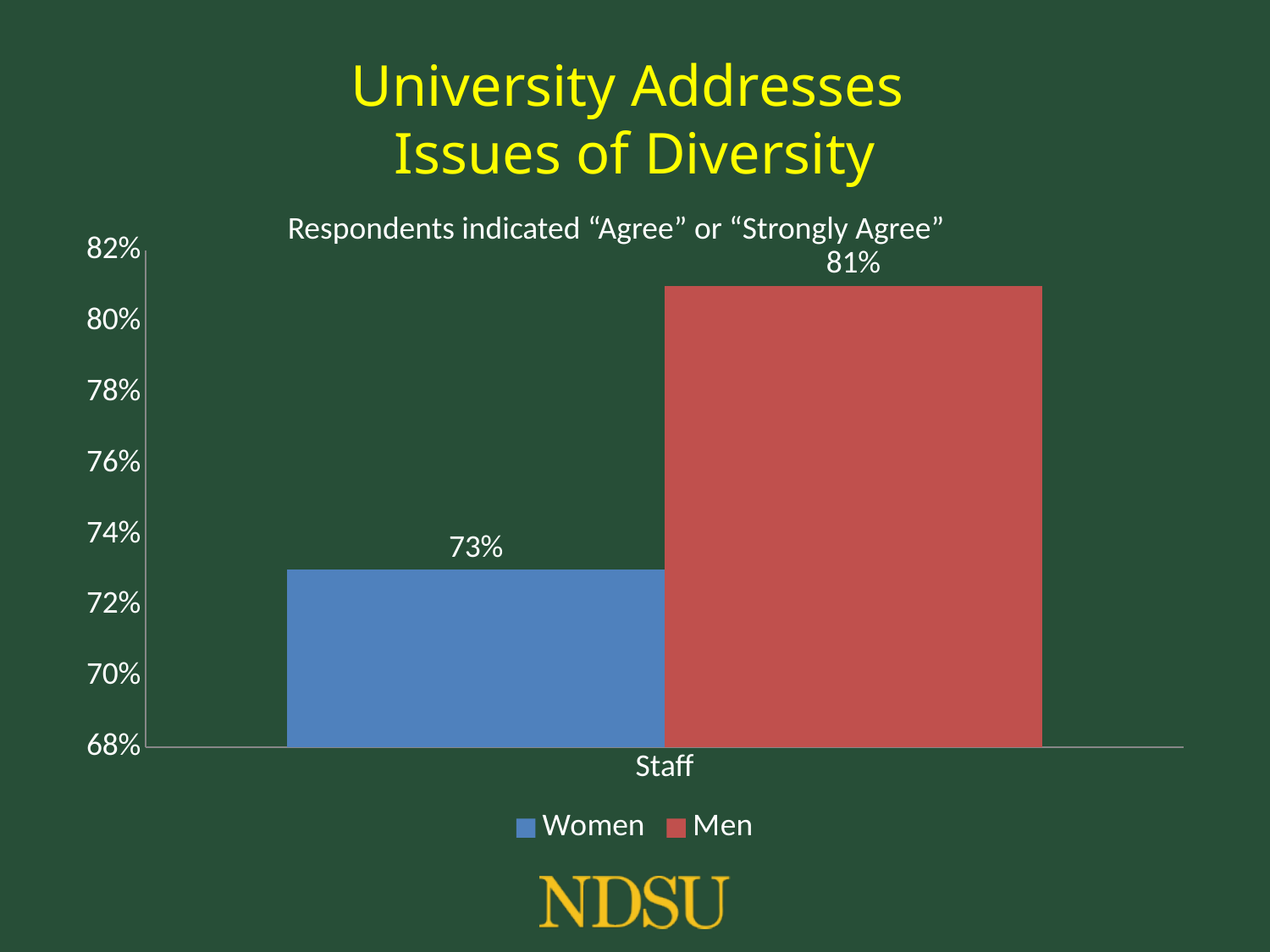
Is the value for Women greater or less than 74%? less What percentage of women staff indicated "Agree" or "Strongly Agree"? 73% What percentage of men staff indicated "Agree" or "Strongly Agree"? 81% Which series has the lowest value on the chart? Women Is the value for Men greater or less than 80%? greater How many series does the legend list? 2 What kind of chart is shown on the slide? Bar chart What colour represents Men in the chart? Red Which series has the higher value for Staff, Women or Men? Men How many categories are shown on the x axis? 1 What is the chart's title? Respondents indicated "Agree" or "Strongly Agree" What is the difference between the Men and Women values for Staff? 8%